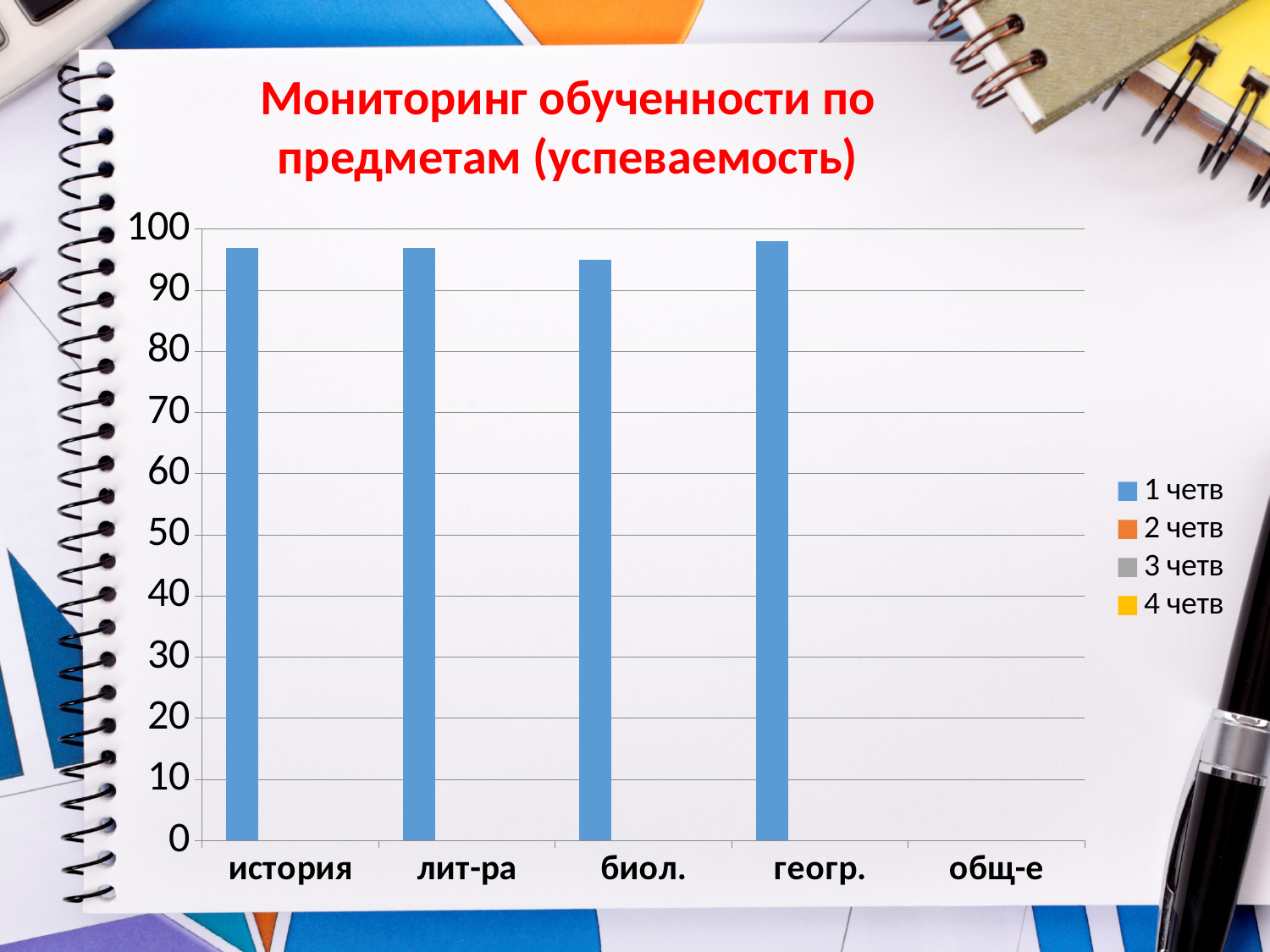
Is the value for лит-ра greater or less than 80? greater Is the value for геогр. greater or less than 100? less What kind of chart is shown on the slide? bar chart What is the title of the chart? Мониторинг обученности по предметам (успеваемость) Is the value for биол. greater or less than 90? greater How many categories are shown on the x axis of the chart? 5 Which category on the x axis has no bar plotted? общ-е Among the categories with a plotted bar, which has the lowest value? биол. How many series does the chart's legend list? 4 Which is larger, the value for биол. or the value for геогр.? геогр.